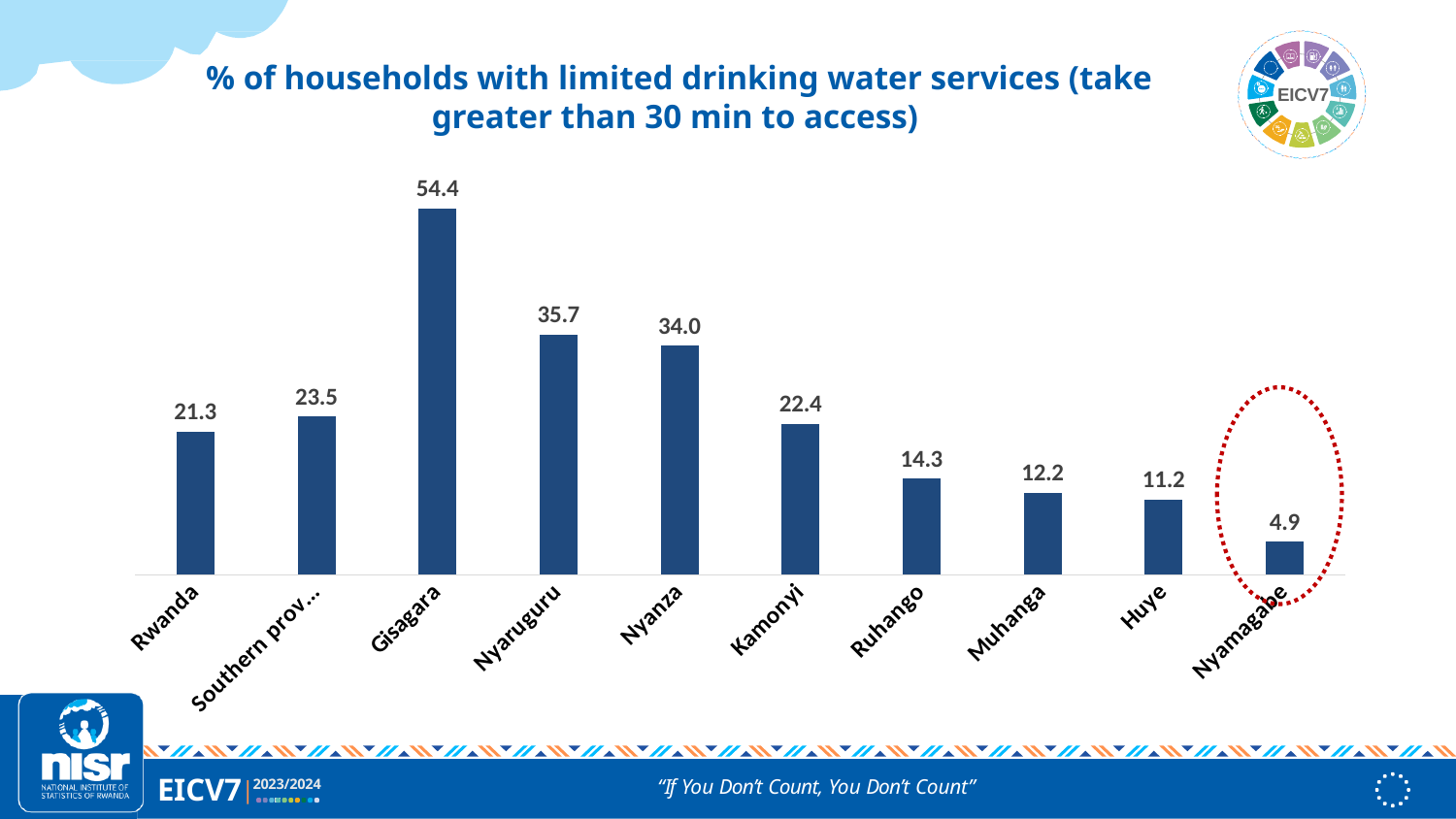
What kind of chart is shown on the slide? Bar chart What is the value for Nyamagabe? 4.9 Which category has the highest value? Gisagara What is the value for Rwanda? 21.3 What is the value for Gisagara? 54.4 Which category has the lowest value? Nyamagabe What is the difference between the values for Gisagara and Nyamagabe? 49.5 Which is larger, the value for Ruhango or the value for Muhanga? Ruhango How many categories are shown on the chart? 10 What is the value for Kamonyi? 22.4 Which category is highlighted with a red dotted circle? Nyamagabe What is the difference between the values for Nyaruguru and Nyanza? 1.7